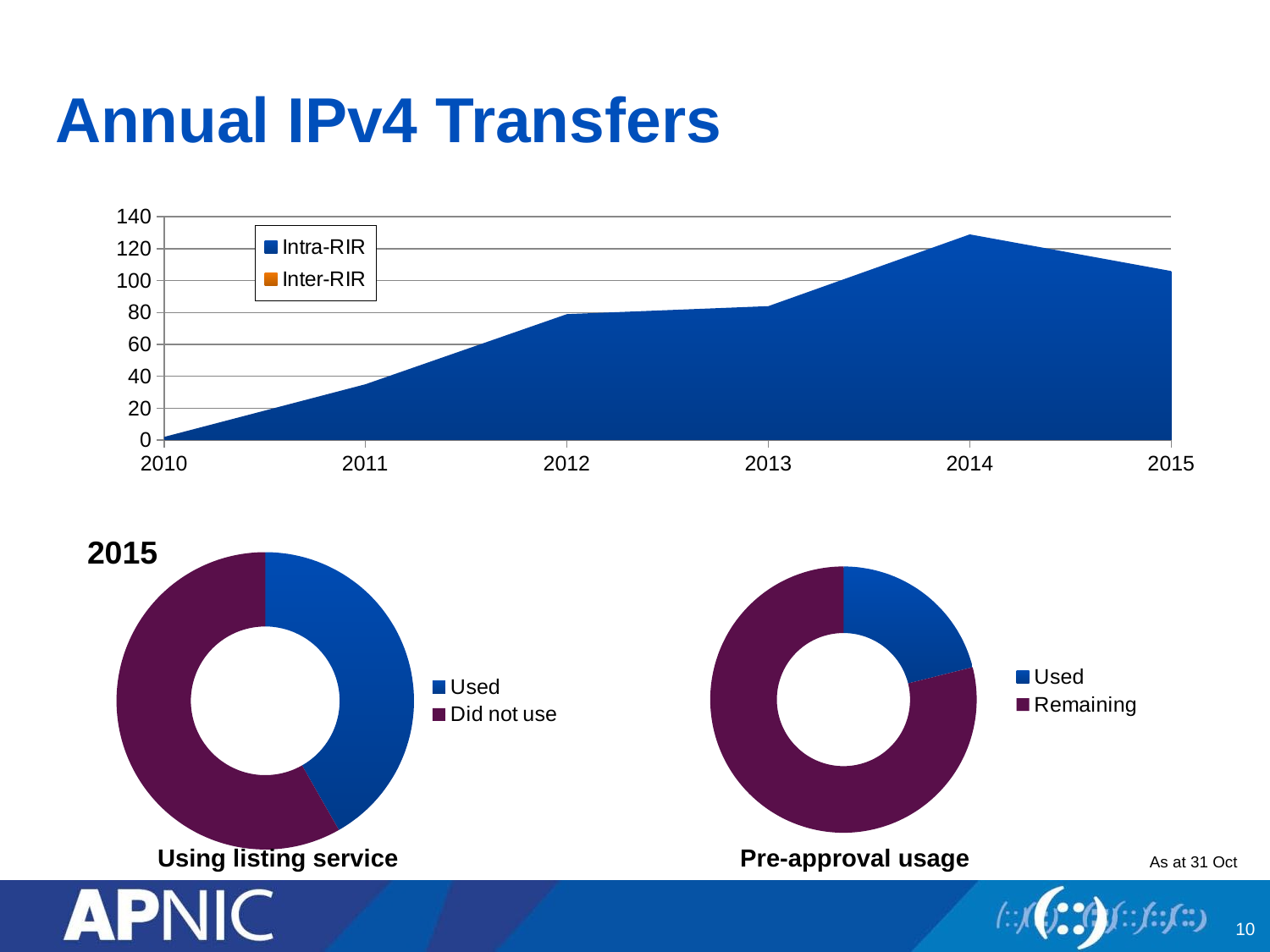
What kind of chart is the Annual IPv4 Transfers chart at the top of the slide? Area chart In the Pre-approval usage chart, which slice is larger, Used or Remaining? Remaining In the Annual IPv4 Transfers chart, is the value for 2015 greater or less than 100? greater How many series does the legend of the Annual IPv4 Transfers chart list? 2 In the Annual IPv4 Transfers chart, is the value for 2010 greater or less than 20? less In the Annual IPv4 Transfers chart, which year has the lowest value? 2010 In the Annual IPv4 Transfers chart, which is larger, the value for 2014 or the value for 2015? 2014 In the Annual IPv4 Transfers chart, is the value for 2014 greater or less than 120? greater In the Annual IPv4 Transfers chart, which year has the highest value? 2014 In the Using listing service chart, which slice is larger, Used or Did not use? Did not use How many years are shown on the x axis of the Annual IPv4 Transfers chart? 6 In the Annual IPv4 Transfers chart, do the values rise or fall from 2010 to 2014? Rise